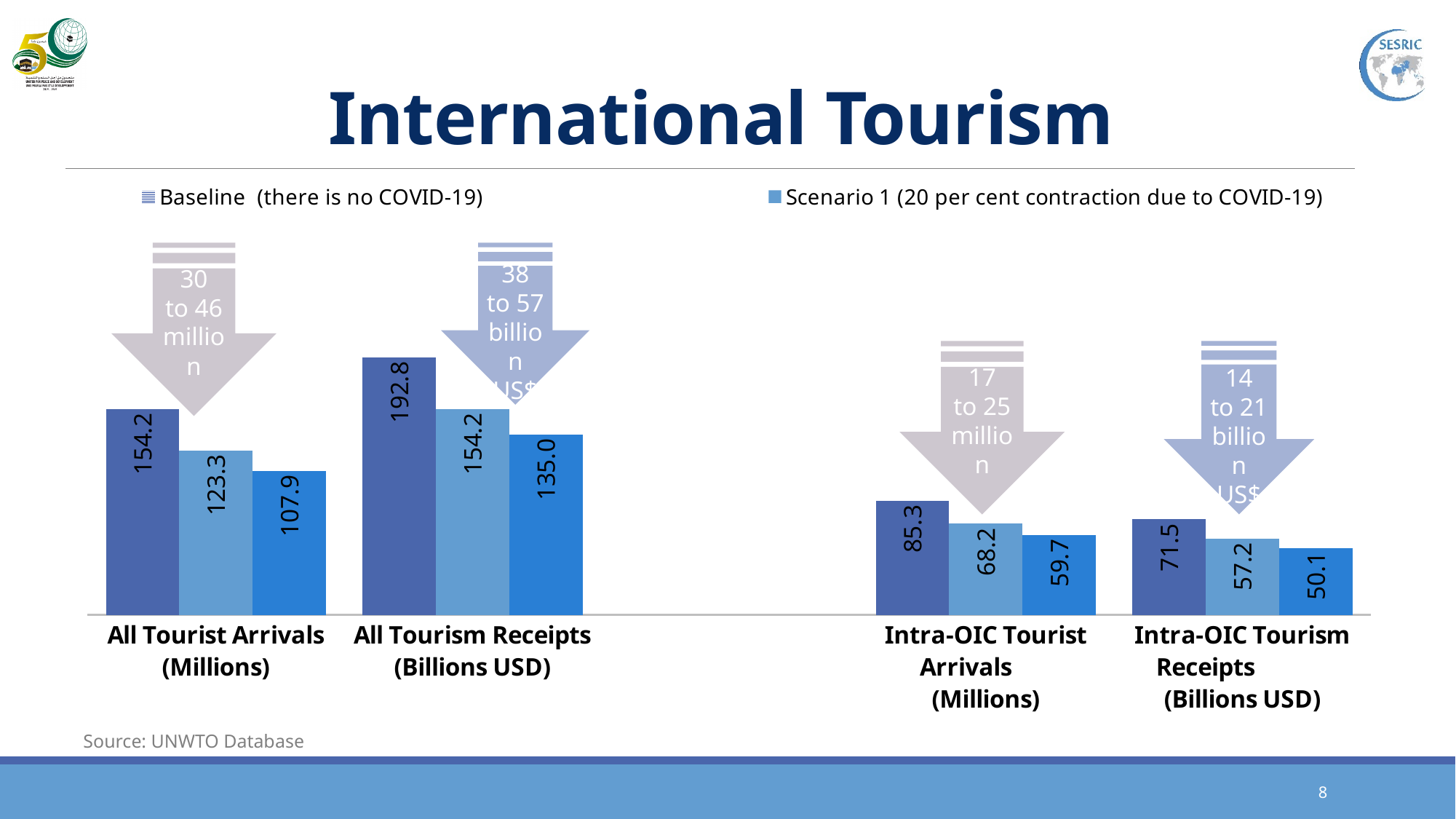
In the right chart, what is the Baseline value for Intra-OIC Tourist Arrivals (Millions)? 85.3 In the right chart, which has the larger Baseline value: Intra-OIC Tourist Arrivals or Intra-OIC Tourism Receipts? Intra-OIC Tourist Arrivals What type of chart is used on this slide? Bar chart In the right chart, what is the difference between the Baseline and Scenario 1 values for Intra-OIC Tourism Receipts (Billions USD)? 14.3 In the right chart, what is the lowest value shown on any bar? 50.1 In the left chart, how much lower is the Scenario 1 value than the Baseline value for All Tourist Arrivals (Millions)? 30.9 How many categories are shown on the x axis of the left chart? 2 In the left chart, what is the Baseline value for All Tourist Arrivals (Millions)? 154.2 In the left chart, what is the Scenario 1 value for All Tourism Receipts (Billions USD)? 154.2 What source is cited for the data on the slide? UNWTO Database In the right chart, what is the Scenario 1 value for Intra-OIC Tourism Receipts (Billions USD)? 57.2 In the left chart, what is the highest value shown on any bar? 192.8